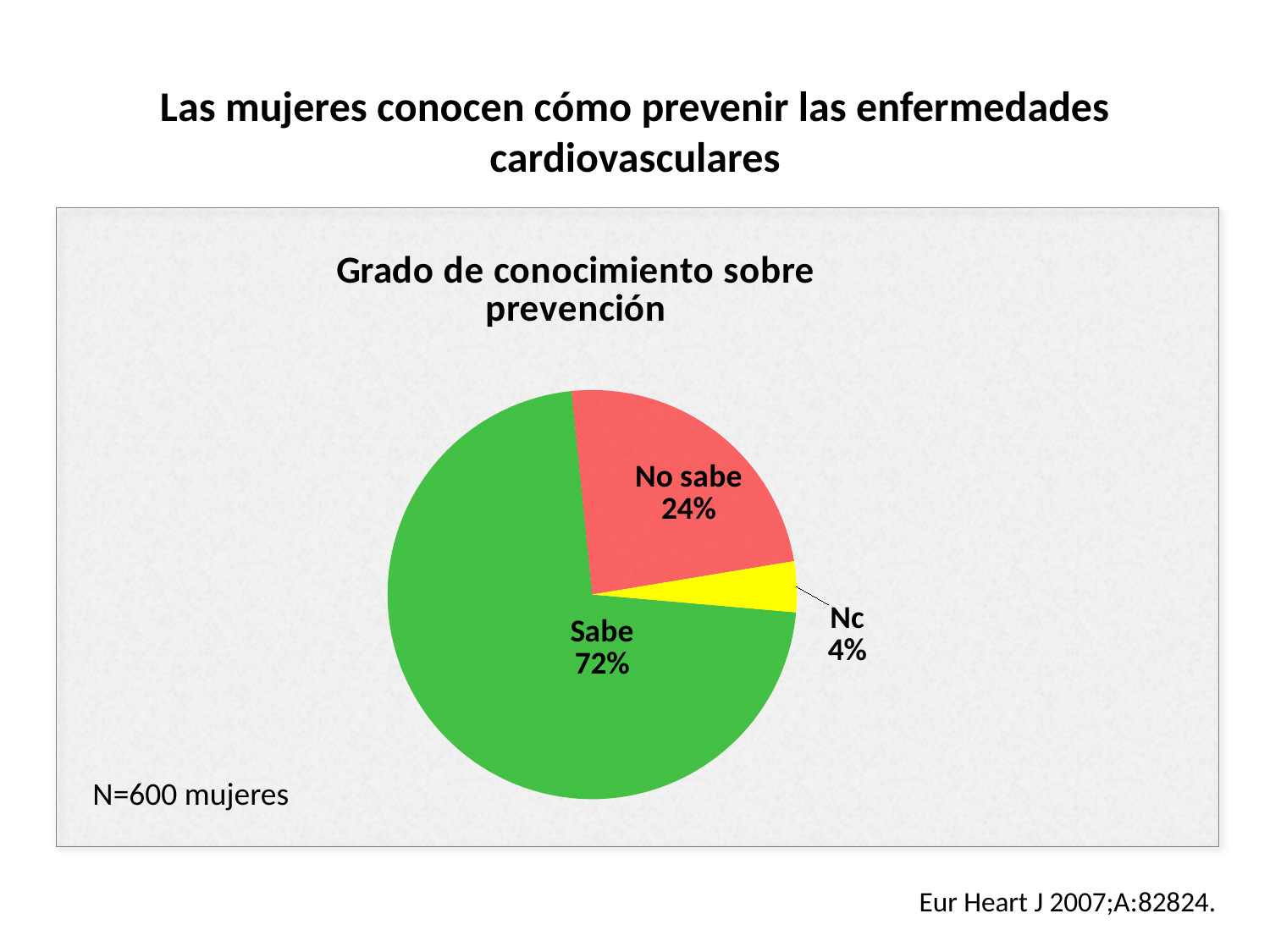
What kind of chart is shown on the slide? pie chart What is the difference in percentage points between the 'No sabe' and 'Nc' slices? 20 What is the title of the chart? Grado de conocimiento sobre prevención Which category has the largest slice of the pie? Sabe How many slices does the pie chart have? 3 Which slice is larger, 'No sabe' or 'Nc'? No sabe What is the difference in percentage points between the 'Sabe' and 'No sabe' slices? 48 Which category has the smallest slice of the pie? Nc What share of the pie does the 'Sabe' slice represent? 72% What share of the pie does the 'No sabe' slice represent? 24% What colour is the 'Sabe' slice? green What share of the pie does the 'Nc' slice represent? 4%